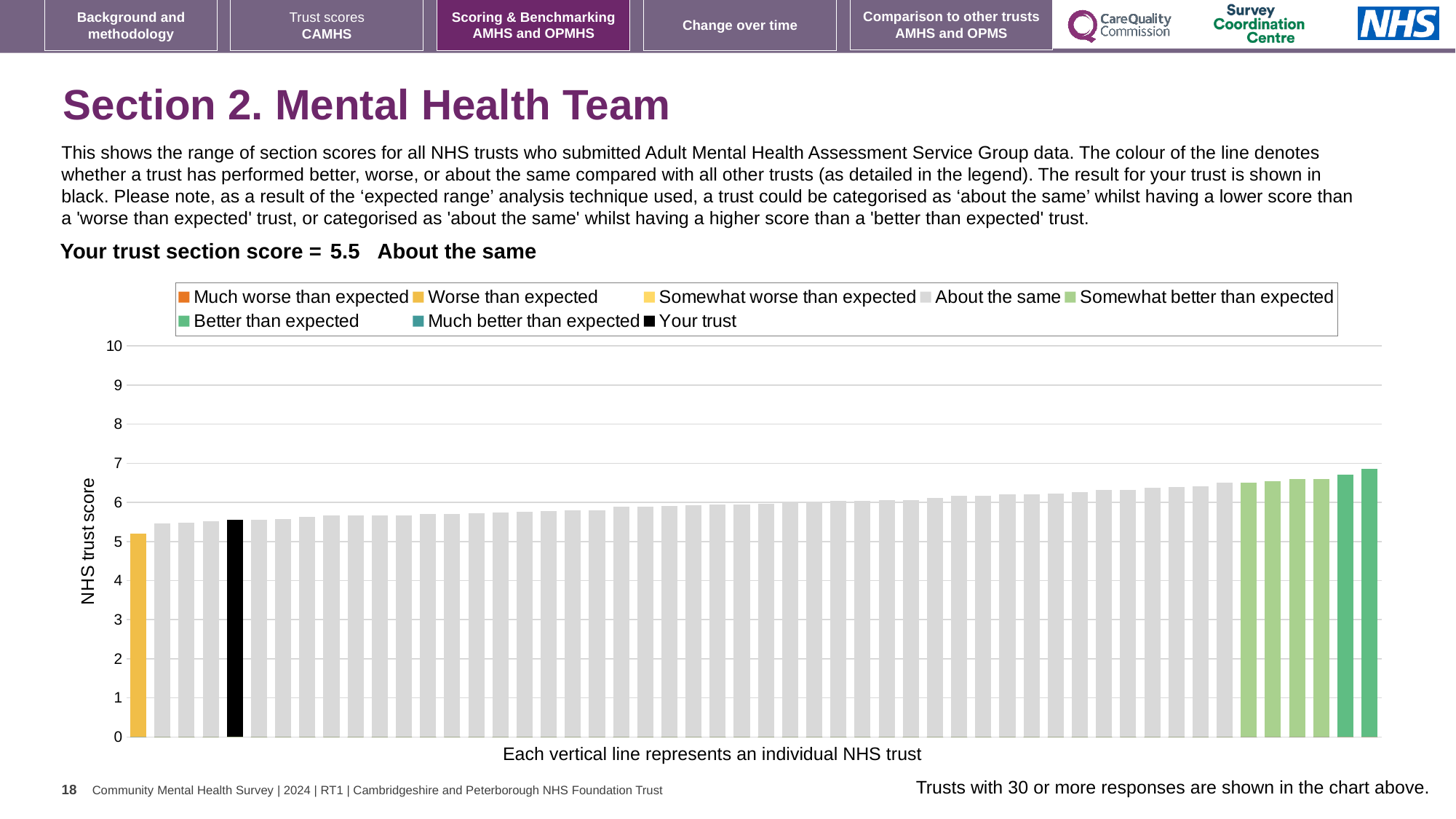
What colour is the bar representing your trust? black Is the value of the rightmost bar greater or less than 7? less Is the value of the black 'Your trust' bar greater or less than 6? less How many entries does the chart legend list? 8 Which category is your trust's section score placed in? About the same Is the value of the rightmost bar greater or less than 6? greater What is the label on the vertical axis of the chart? NHS trust score What kind of chart is shown on the slide? bar chart What is the section score for your trust? 5.5 Do the bar values rise or fall from left to right across the chart? rise What is the highest value shown on the vertical axis? 10